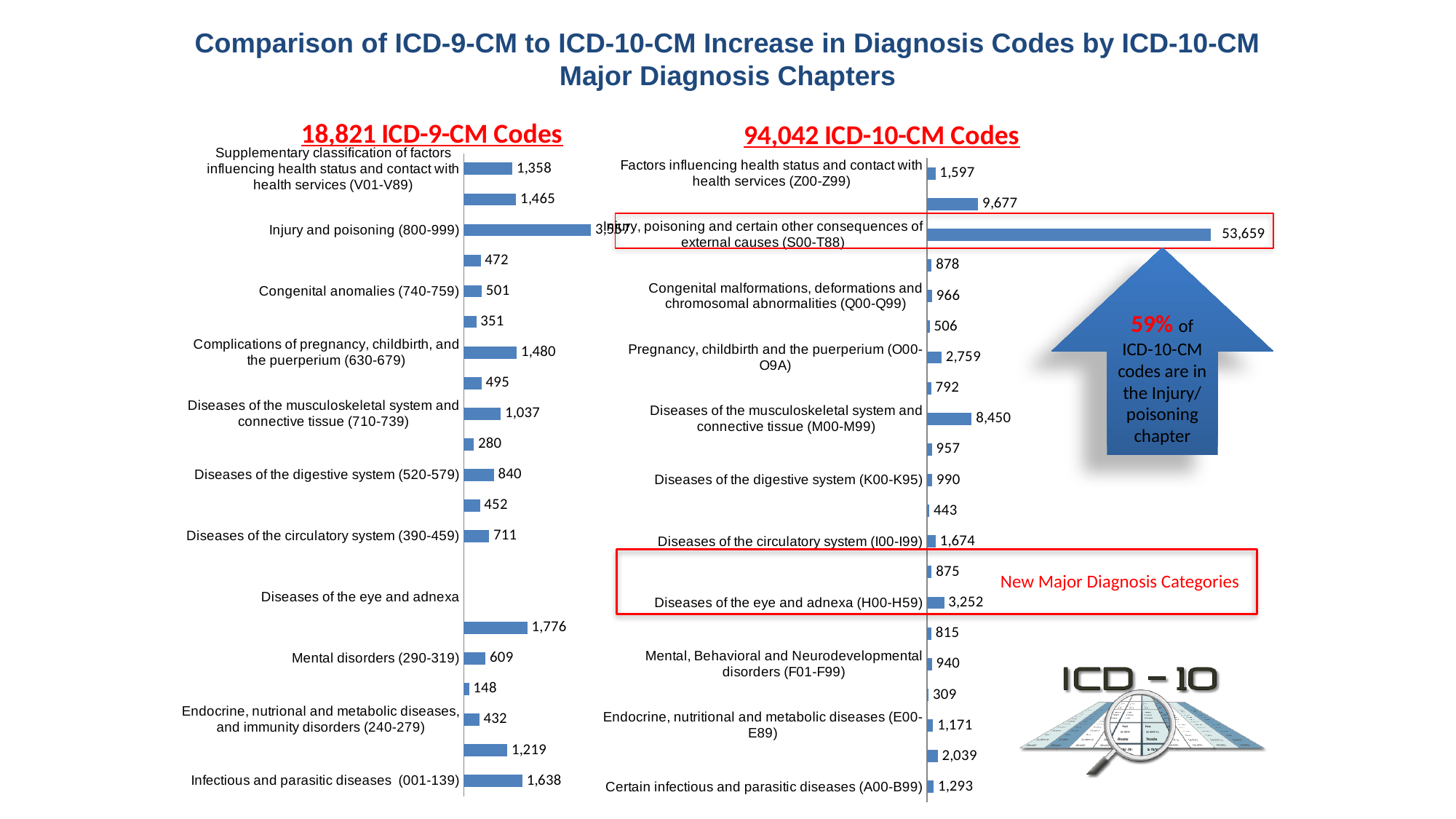
In the 94,042 ICD-10-CM Codes chart, what is the difference between Diseases of the eye and adnexa (H00-H59) and Diseases of the circulatory system (I00-I99)? 1,578 What is the difference between the musculoskeletal system value in the 94,042 ICD-10-CM Codes chart (8,450) and the musculoskeletal system value in the 18,821 ICD-9-CM Codes chart (1,037)? 7,413 In the 94,042 ICD-10-CM Codes chart, what is the value for Diseases of the eye and adnexa (H00-H59)? 3,252 In the 94,042 ICD-10-CM Codes chart, which category has the highest value? Injury, poisoning and certain other consequences of external causes (S00-T88) According to the arrow annotation, what percentage of ICD-10-CM codes are in the Injury/poisoning chapter? 59% In the 18,821 ICD-9-CM Codes chart, which category has the longest bar? Injury and poisoning (800-999) In the 94,042 ICD-10-CM Codes chart, what is the value for Diseases of the musculoskeletal system and connective tissue (M00-M99)? 8,450 What kind of chart is used on this slide? Bar chart In the 94,042 ICD-10-CM Codes chart, what is the value for Injury, poisoning and certain other consequences of external causes (S00-T88)? 53,659 In the 18,821 ICD-9-CM Codes chart, which is larger: Infectious and parasitic diseases (001-139) or Complications of pregnancy, childbirth, and the puerperium (630-679)? Infectious and parasitic diseases (001-139) In the 18,821 ICD-9-CM Codes chart, what is the value for Infectious and parasitic diseases (001-139)? 1,638 In the 18,821 ICD-9-CM Codes chart, what is the value for Complications of pregnancy, childbirth, and the puerperium (630-679)? 1,480